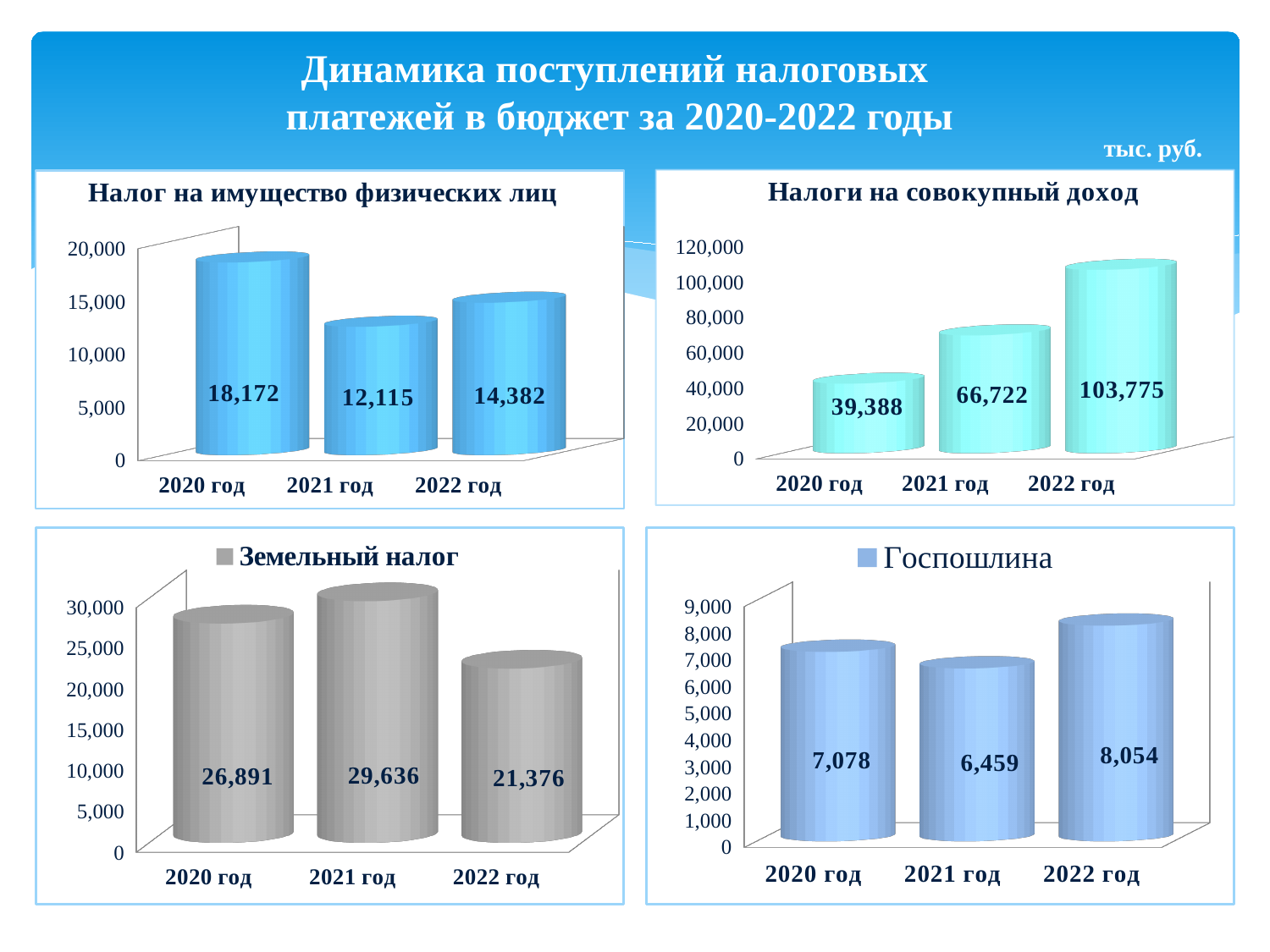
In the chart titled "Налоги на совокупный доход", do the values rise or fall from 2020 год to 2022 год? rise In the chart titled "Налоги на совокупный доход", what is the difference between the values for 2022 год and 2020 год? 64,387 In the chart titled "Госпошлина", which is larger, the value for 2020 год or 2022 год? 2022 год In the chart titled "Госпошлина", how many years are shown on the x axis? 3 In the chart titled "Земельный налог", which year has the highest value? 2021 год In the chart titled "Земельный налог", what is the value for 2021 год? 29,636 In the chart titled "Налог на имущество физических лиц", which year has the lowest value? 2021 год In the chart titled "Земельный налог", what is the difference between the values for 2021 год and 2022 год? 8,260 What kind of chart is the one titled "Налог на имущество физических лиц"? bar chart In the chart titled "Госпошлина", what is the value for 2021 год? 6,459 In the chart titled "Налоги на совокупный доход", what is the value for 2022 год? 103,775 In the chart titled "Налог на имущество физических лиц", what is the value for 2020 год? 18,172